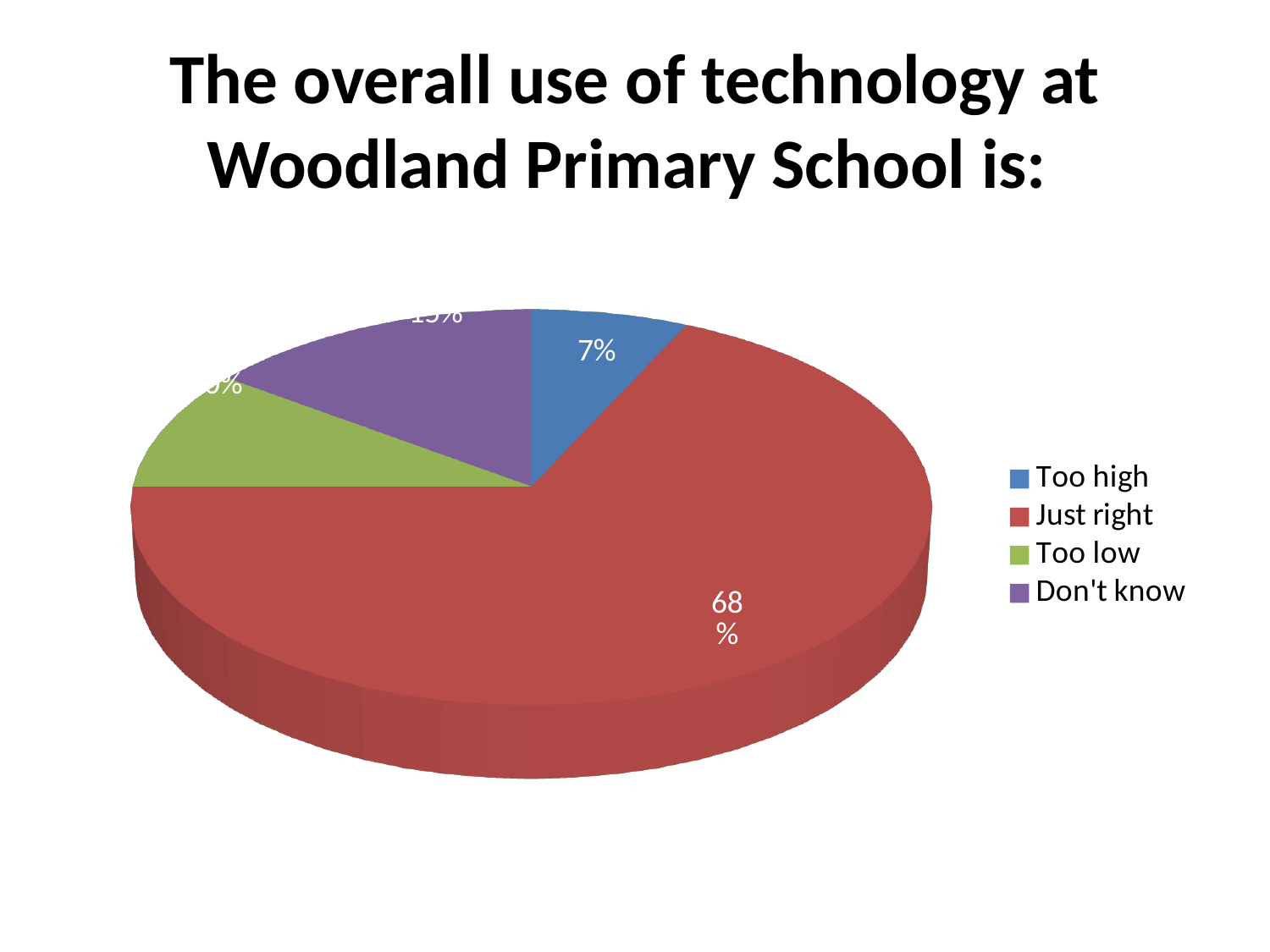
What percentage of the pie is labelled for the 'Just right' slice? 68% What is the title of the slide? The overall use of technology at Woodland Primary School is: What kind of chart is shown on the slide? Pie chart How many categories does the pie chart show? 4 What colour represents 'Just right' in the legend? Red What is the difference in percentage points between the 'Just right' slice and the 'Too high' slice? 61 percentage points How many entries does the legend list? 4 Which is larger, the 'Just right' slice or the 'Don't know' slice? Just right Which category has the largest slice of the pie? Just right Which is larger, the 'Just right' slice or the 'Too high' slice? Just right What percentage is shown for the 'Too high' slice? 7% What share of the pie does 'Too high' represent? 7%